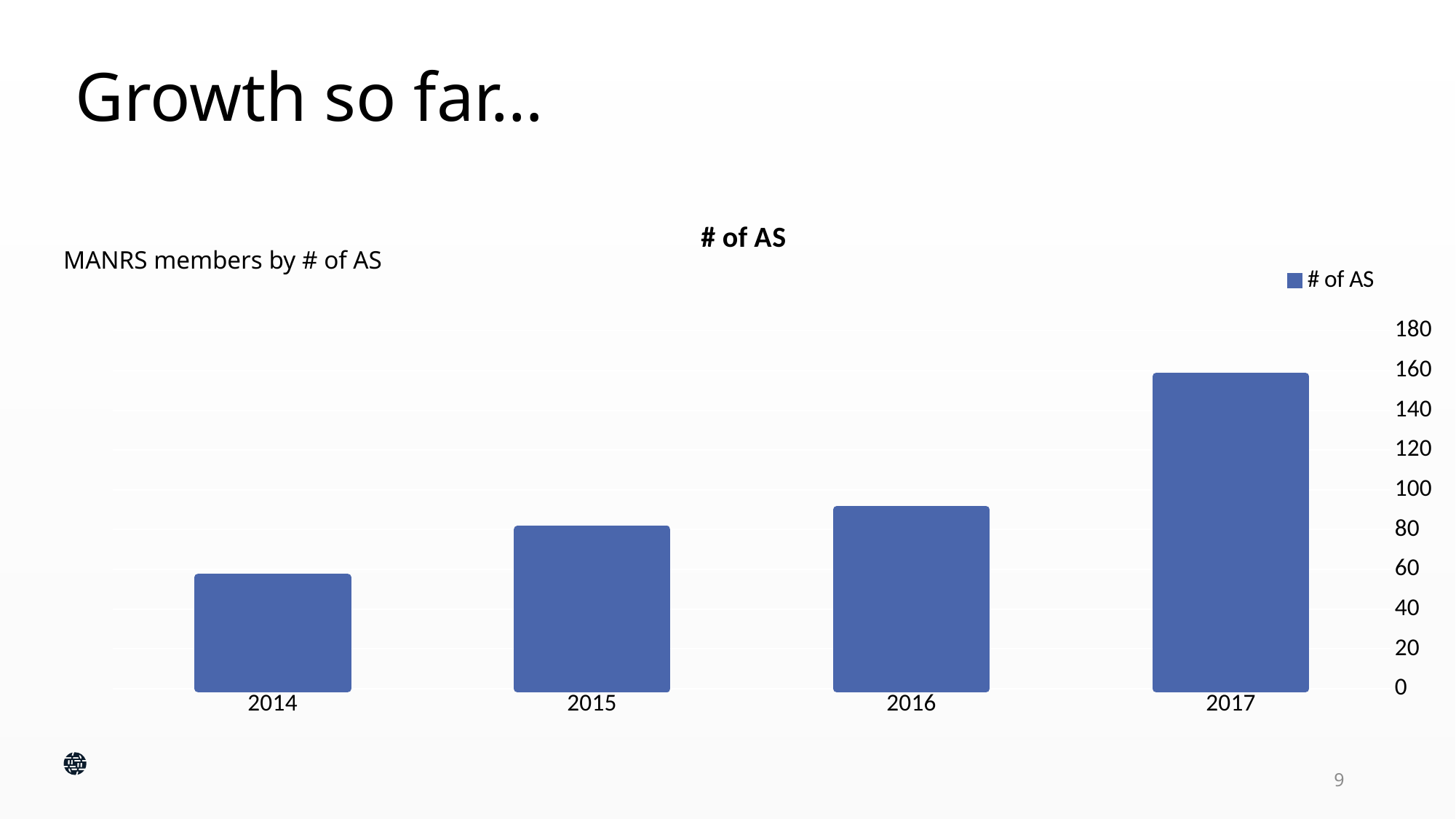
What is the title of the chart? # of AS How many series does the legend list? 1 Is the value for 2015 greater or less than 100? less How many years are shown on the x axis of the chart? 4 What kind of chart is shown on the slide? bar chart Which year has the highest # of AS? 2017 Which is larger, the value for 2016 or the value for 2015? 2016 Is the value for 2016 greater or less than 100? less Is the value for 2014 greater or less than 40? greater Do the values rise or fall from 2014 to 2017? rise Which year has the lowest # of AS? 2014